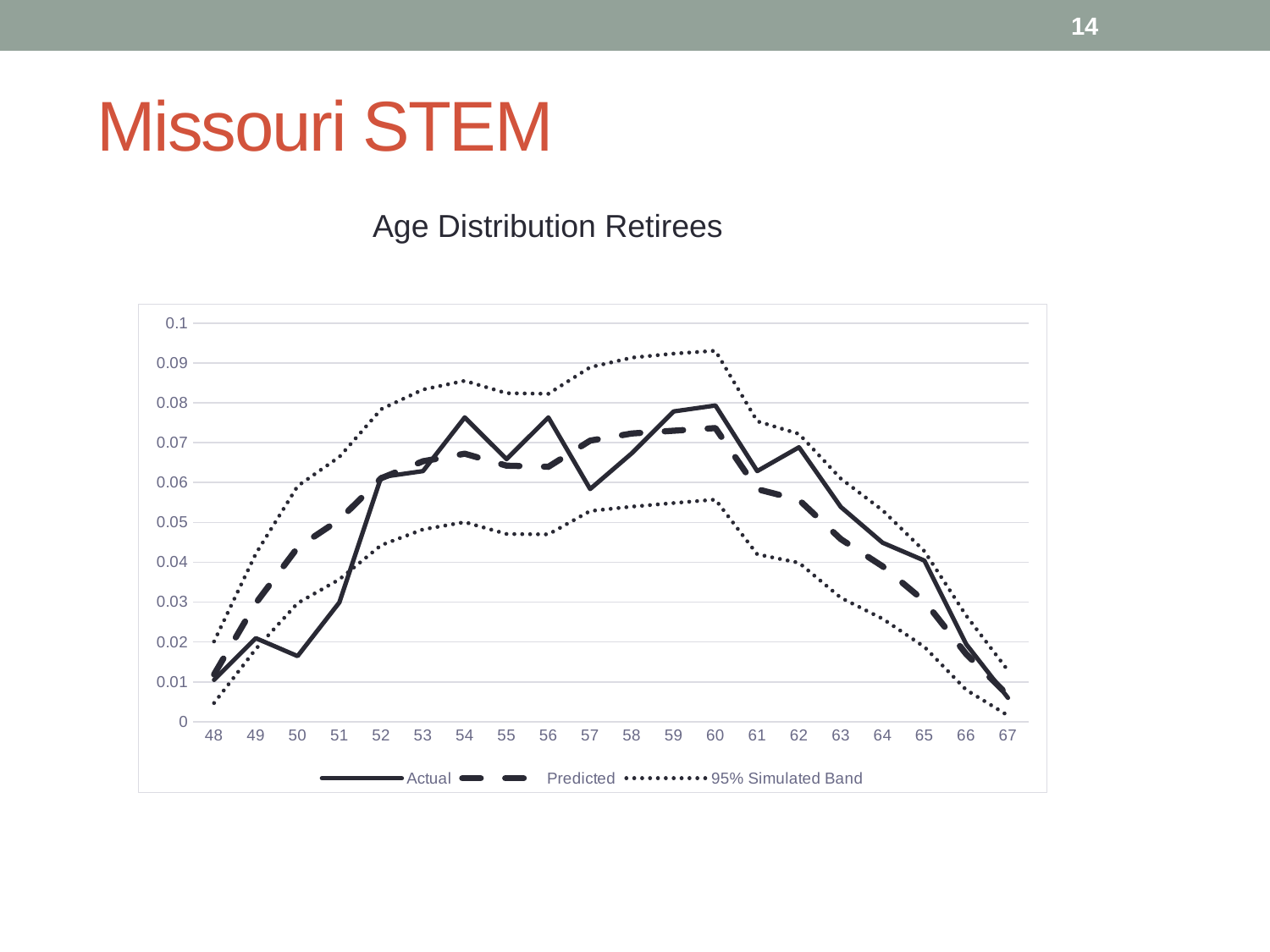
How many series does the legend list? 3 Is the upper 95% Simulated Band value at age 60 greater or less than 0.09? greater What is the title of the chart? Age Distribution Retirees Is the Actual value at age 48 greater or less than 0.02? less At which age is the Actual series lowest? 67 Which is larger, the Actual value at age 52 or at age 48? age 52 Is the Predicted value at age 67 greater or less than 0.01? less How many age categories are shown on the x axis? 20 What kind of chart is shown on the slide? line chart Does the Actual series rise or fall from age 60 to age 67? fall